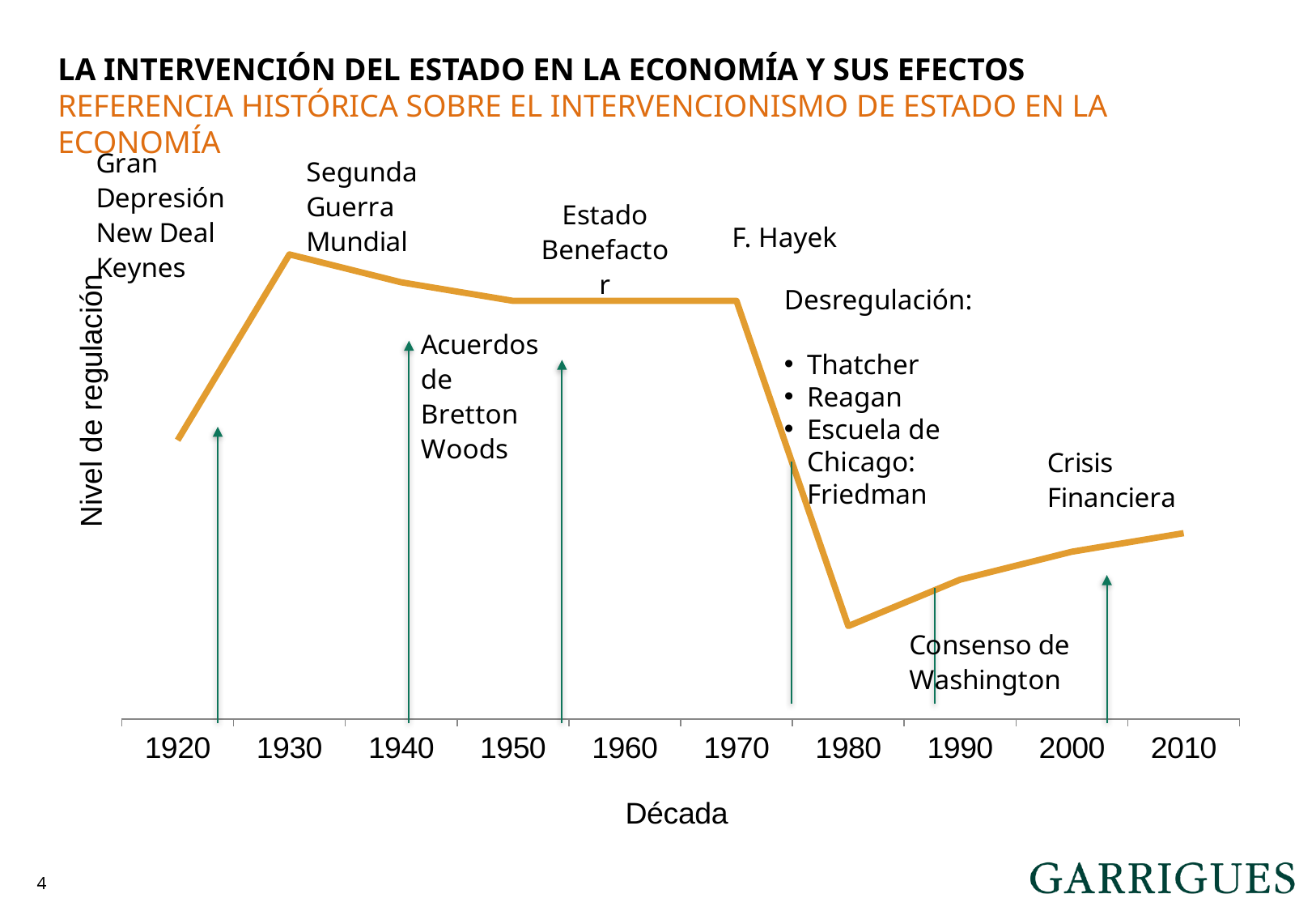
In which decade does the line reach its highest level of regulation? 1930 Which decade shows a higher level of regulation, 1920 or 2010? 1920 Does the level of regulation rise or fall between 1980 and 2010? rise How many decades are labelled on the x axis of the chart? 10 Does the level of regulation rise or fall between 1970 and 1980? fall Which decade shows a higher level of regulation, 1930 or 1980? 1930 What is the title of the x axis of the chart? Década Does the level of regulation rise or fall between 1920 and 1930? rise What kind of chart is shown on the slide? line chart In which decade does the line reach its lowest level of regulation? 1980 Which decade shows a higher level of regulation, 1960 or 1990? 1960 What is the title of the y axis of the chart? Nivel de regulación